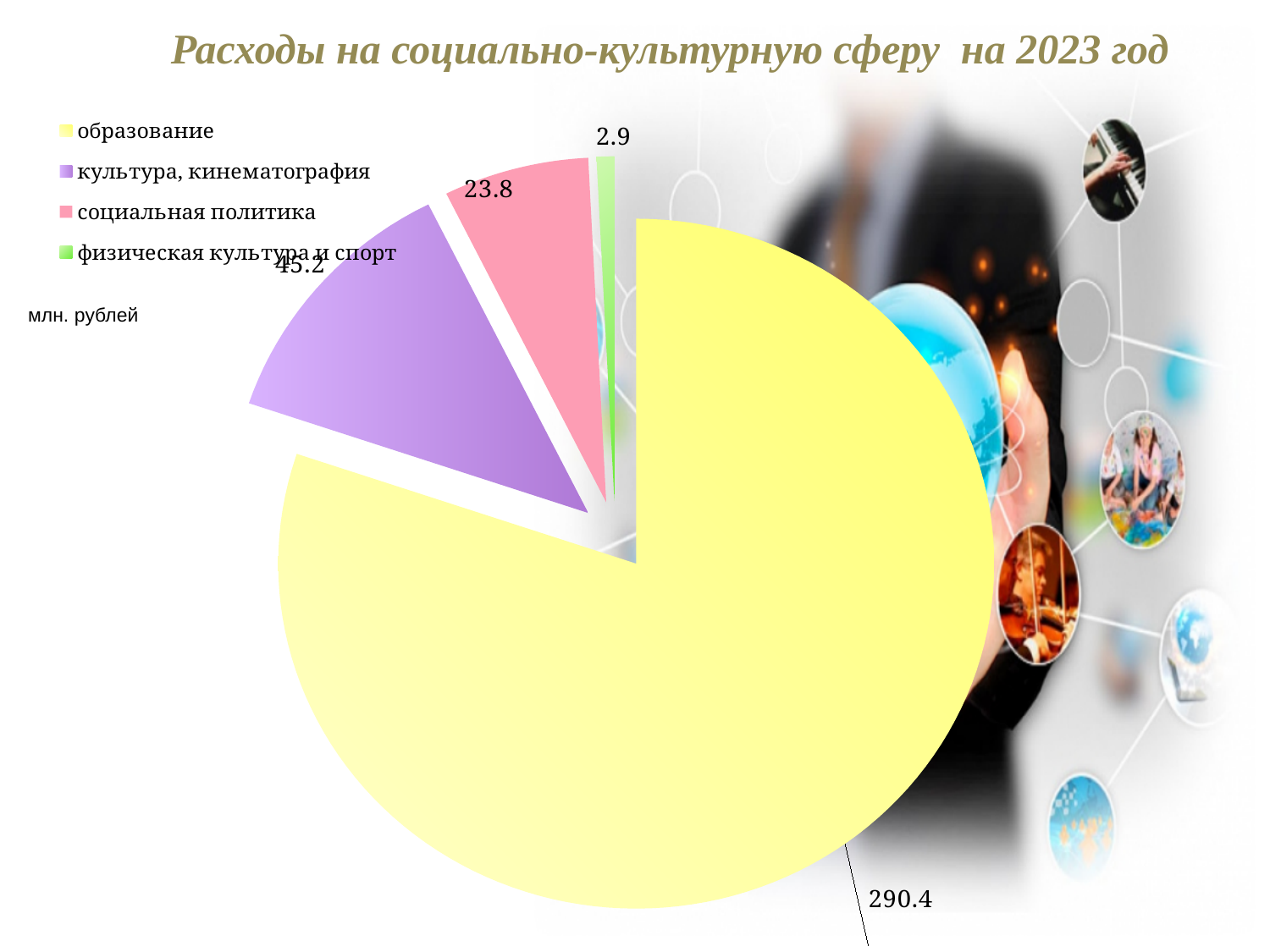
What is the difference between the values for образование and культура, кинематография? 245.2 What is the difference between the values for социальная политика and физическая культура и спорт? 20.9 Which is larger, the value for культура, кинематография or the value for социальная политика? культура, кинематография What type of chart is shown on the slide? pie chart What unit is indicated for the values on the chart? млн. рублей What is the value for социальная политика? 23.8 What is the value for образование? 290.4 How many categories does the pie chart have? 4 Which category has the largest slice of the pie? образование Which category has the smallest slice of the pie? физическая культура и спорт What is the value for культура, кинематография? 45.2 What is the value for физическая культура и спорт? 2.9